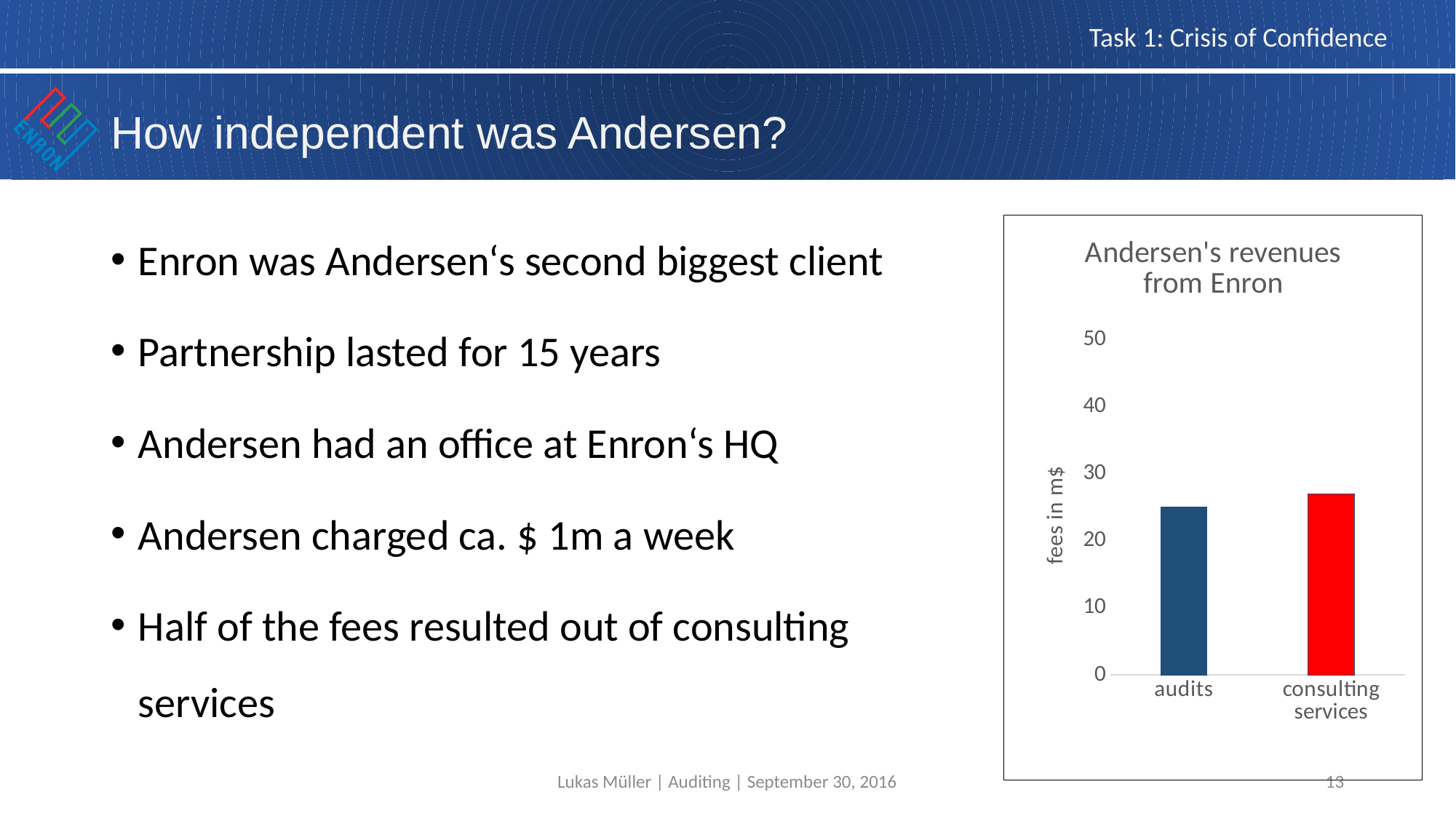
What is the label of the vertical axis of the chart? fees in m$ What kind of chart is shown on the slide? bar chart Is the value for audits greater or less than 20? greater Is the value for audits greater or less than 40? less How many categories are plotted in the chart? 2 Which category has the lowest value in the chart? audits Is the value for audits greater or less than 30? less Which category has the higher value, audits or consulting services? consulting services What is the title of the chart? Andersen's revenues from Enron